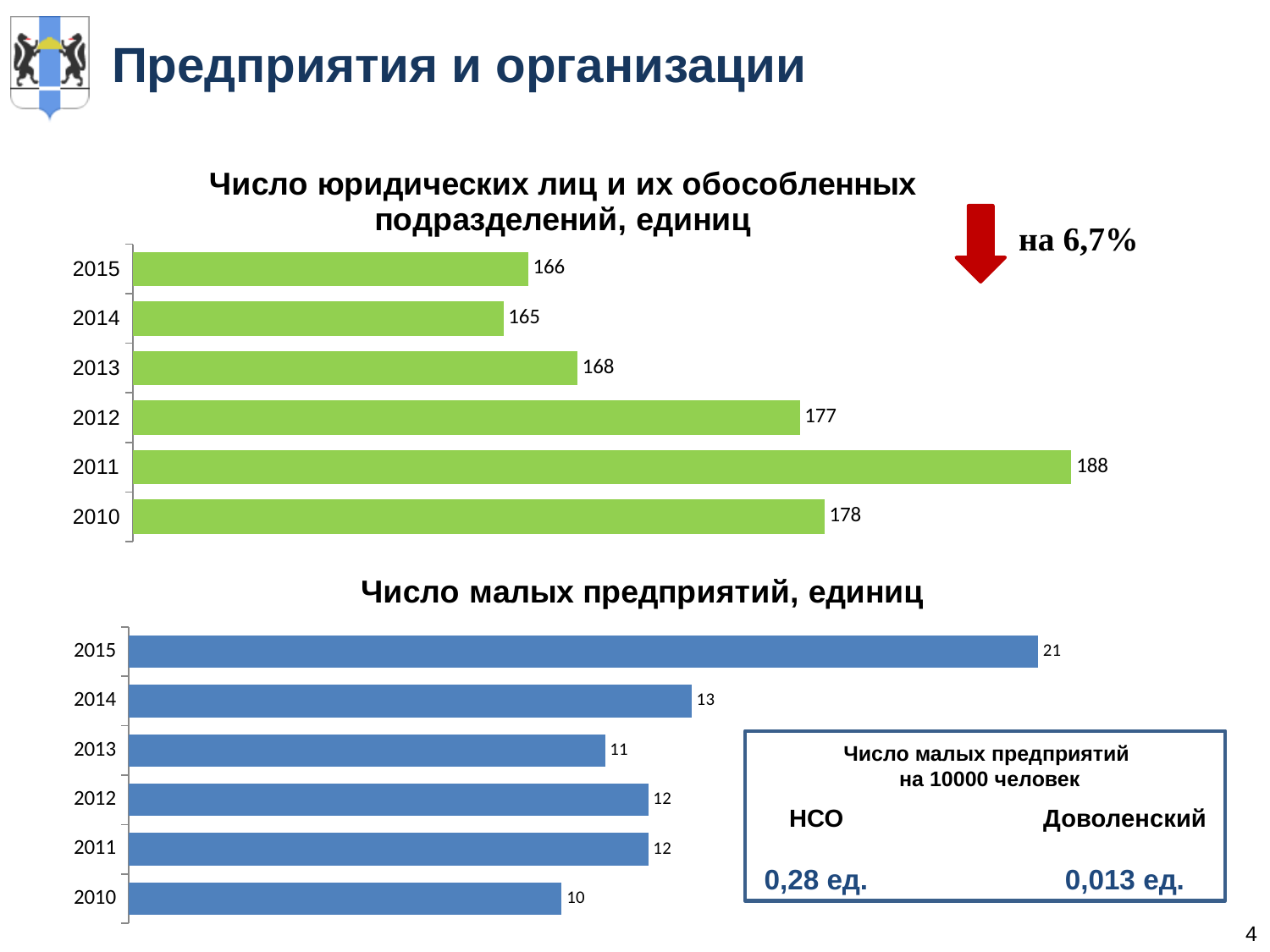
What type of chart is 'Число малых предприятий, единиц'? Bar chart In the chart 'Число малых предприятий, единиц', what is the value for 2015? 21 In the chart 'Число юридических лиц и их обособленных подразделений, единиц', which year has the highest value? 2011 In the chart 'Число малых предприятий, единиц', what is the difference between the values for 2015 and 2014? 8 In the chart 'Число малых предприятий, единиц', which is larger, the value for 2014 or the value for 2013? 2014 In the chart 'Число юридических лиц и их обособленных подразделений, единиц', which year has the lowest value? 2014 In the chart 'Число юридических лиц и их обособленных подразделений, единиц', how many years are shown? 6 In the chart 'Число юридических лиц и их обособленных подразделений, единиц', what is the value for 2015? 166 In the chart 'Число малых предприятий, единиц', which year has the highest value? 2015 In the chart 'Число юридических лиц и их обособленных подразделений, единиц', what is the value for 2011? 188 In the chart 'Число малых предприятий, единиц', what is the value for 2010? 10 In the chart 'Число юридических лиц и их обособленных подразделений, единиц', what is the difference between the values for 2011 and 2015? 22